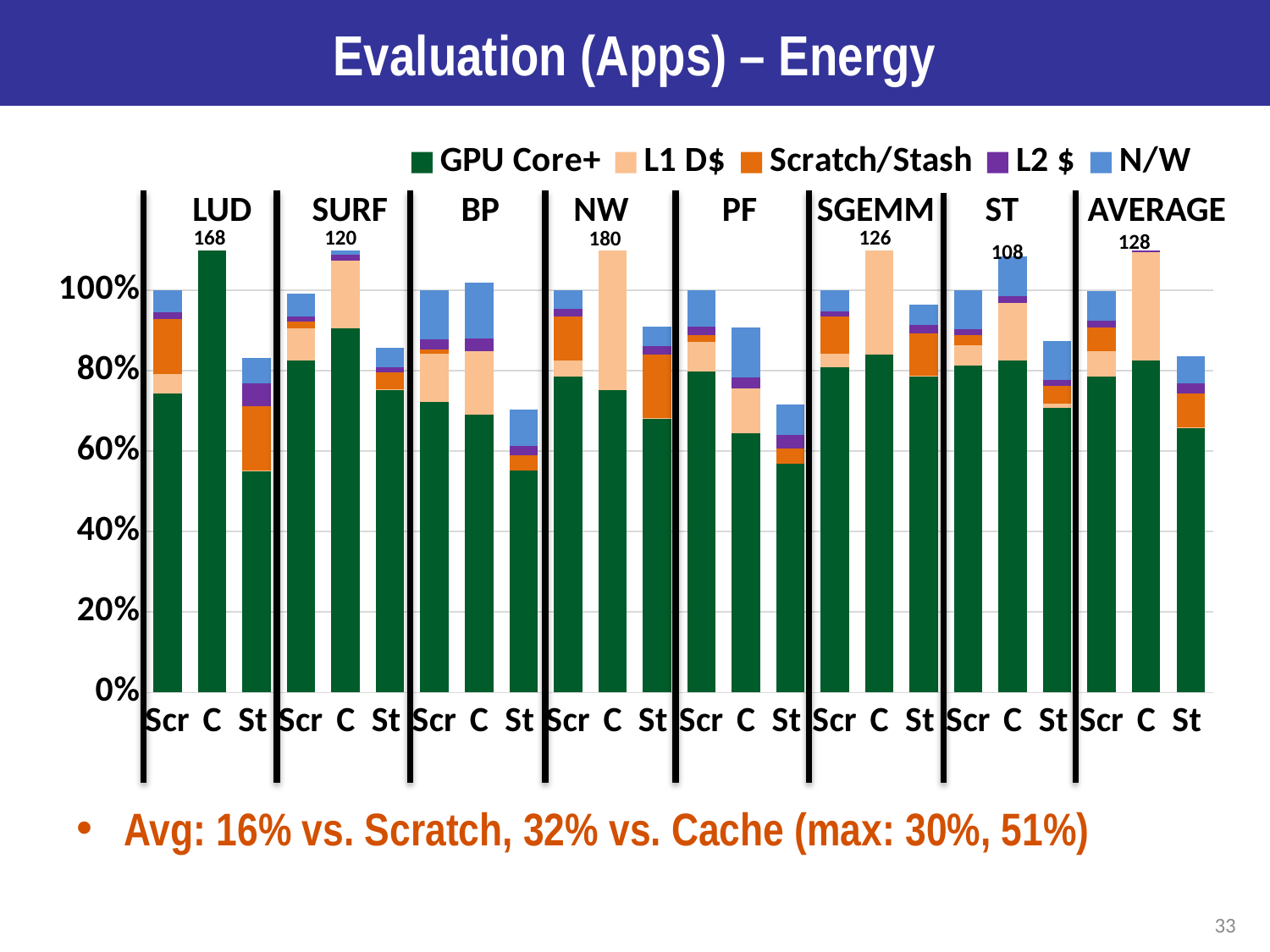
Among the C bars with printed values, which application group has the highest value? NW Which is larger: the printed value for the C bar in LUD or the C bar in SURF? LUD What value is printed above the C bar in the AVERAGE group? 128 What kind of chart is shown on the slide? stacked bar chart How many application groups (including AVERAGE) are shown along the x axis? 8 How many series does the legend list? 5 What value is printed above the C bar in the NW group? 180 Is the total of the St bar in the PF group greater or less than 80%? less What value is printed above the C bar in the ST group? 108 Among the C bars with printed values, which application group has the lowest value? ST What is the difference between the printed values for the C bars in the NW and ST groups? 72 What value is printed above the C bar in the LUD group? 168